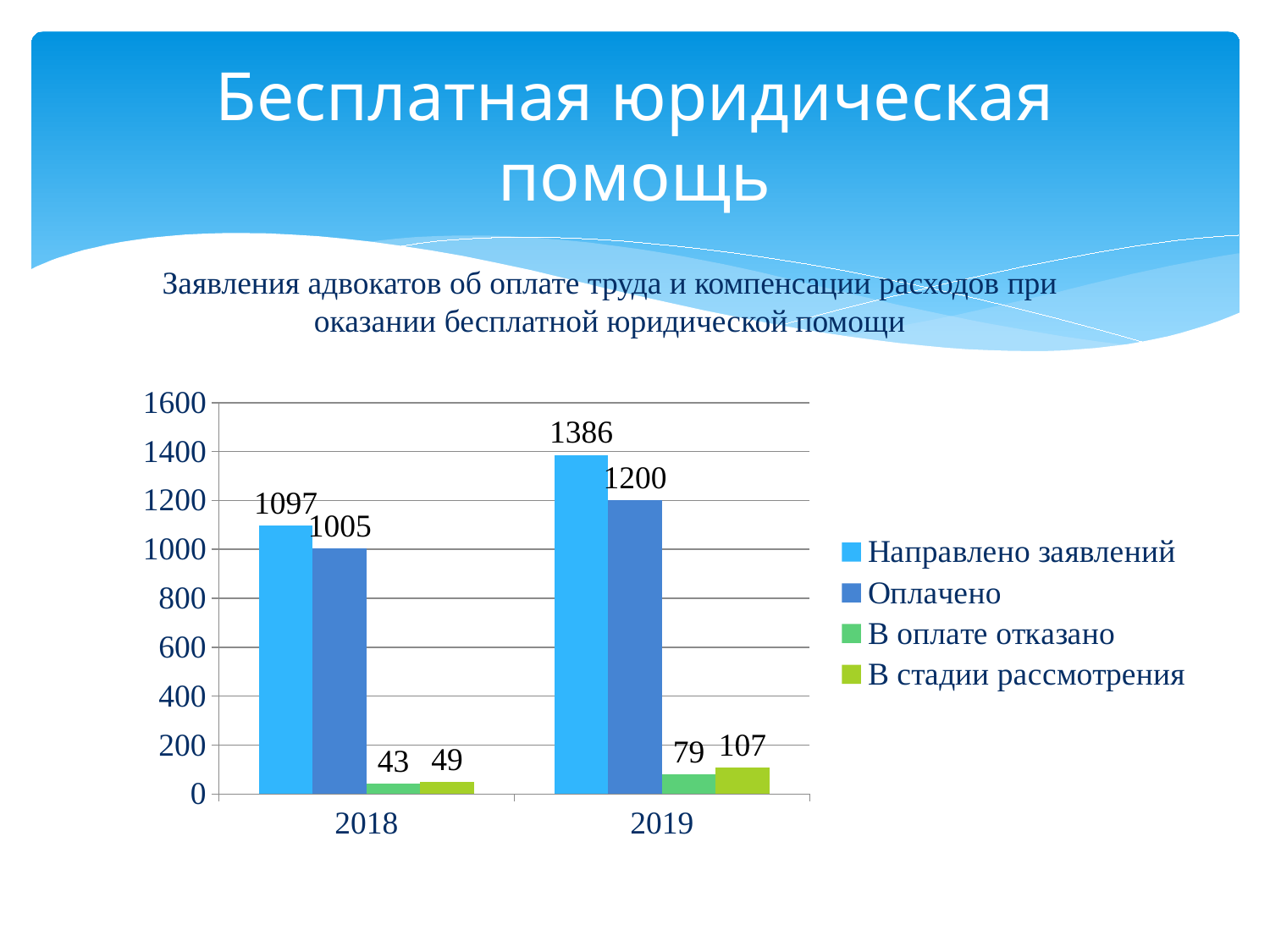
How many series does the legend list? 4 What kind of chart is shown on the slide? Bar chart What is the difference between "Направлено заявлений" in 2019 and in 2018? 289 What is the value for "Направлено заявлений" in 2018? 1097 What is the value for "В оплате отказано" in 2018? 43 What is the value for "Оплачено" in 2019? 1200 What is the value for "В стадии рассмотрения" in 2019? 107 Which series has the highest value in 2019? Направлено заявлений How many categories are shown on the x axis? 2 Does the value for "В оплате отказано" rise or fall from 2018 to 2019? Rise Which is larger: "Оплачено" in 2018 or "Оплачено" in 2019? 2019 Which series has the lowest value in 2018? В оплате отказано